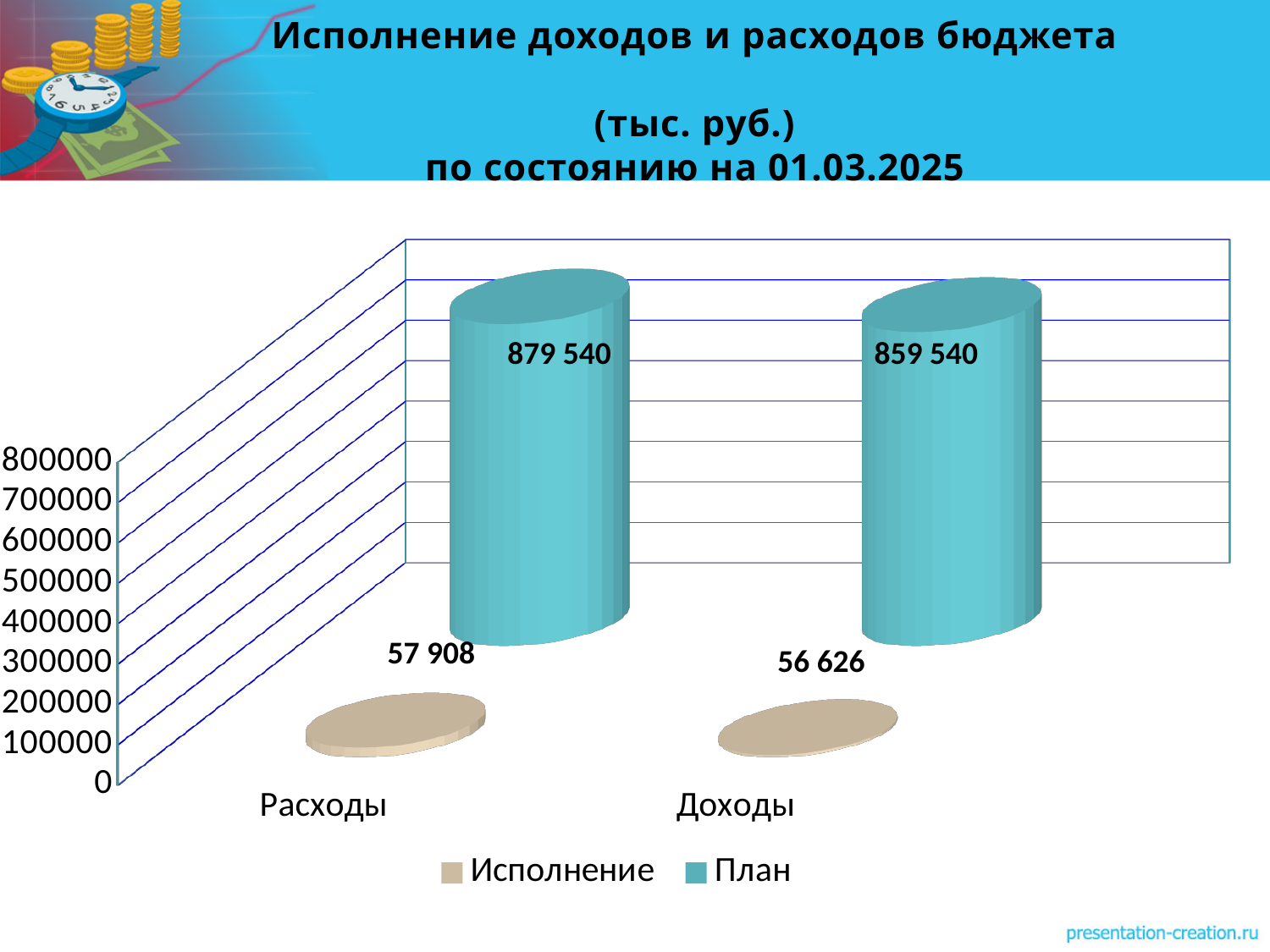
What is the difference between the Исполнение values for Расходы and Доходы? 1 282 What is the difference between the План values for Расходы and Доходы? 20 000 What is the Исполнение value for Доходы? 56 626 What is the План value for Доходы? 859 540 Which category has the higher План value? Расходы Is the Исполнение value for Расходы greater or less than 100000? less How many series does the legend list? 2 What is the Исполнение value for Расходы? 57 908 What is the План value for Расходы? 879 540 How many categories are shown on the x axis? 2 Which category has the lower Исполнение value? Доходы What kind of chart is shown on the slide? bar chart